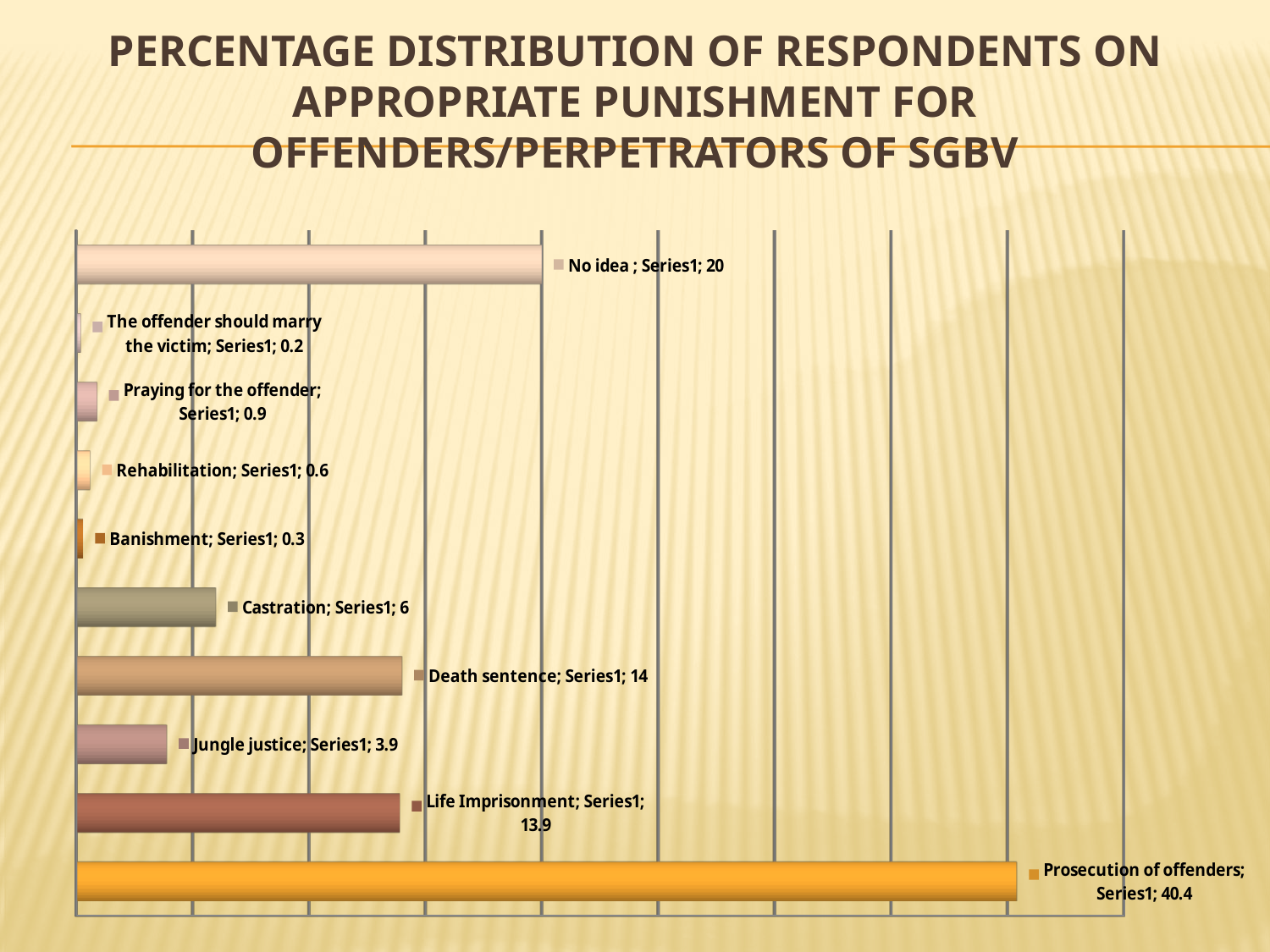
What kind of chart is shown on the slide? Bar chart Which category has the lowest value? The offender should marry the victim How many categories are shown in the chart? 10 Which category has the highest value? Prosecution of offenders What is the difference between the values for Death sentence and Castration? 8 What is the value for No idea? 20 What is the value for Prosecution of offenders? 40.4 What is the value for Jungle justice? 3.9 What is the value for Banishment? 0.3 What is the value for Life Imprisonment? 13.9 Which is larger, the value for Castration or the value for Jungle justice? Castration What is the difference between the values for Prosecution of offenders and No idea? 20.4